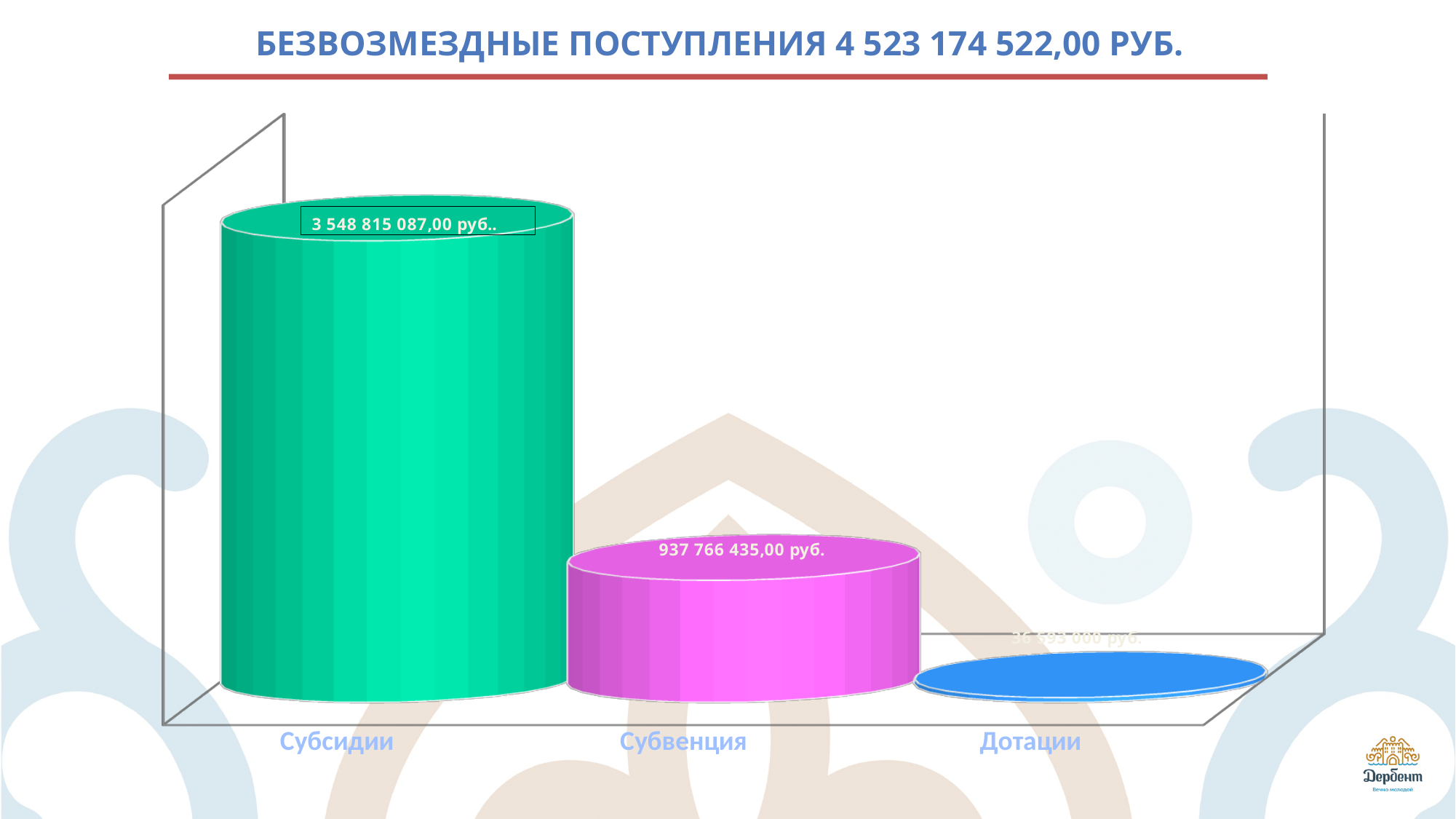
What is the difference between the values for Субсидии and Субвенция? 2 611 048 652,00 руб. What is the value shown for Субсидии? 3 548 815 087,00 руб. What is the title of the slide? БЕЗВОЗМЕЗДНЫЕ ПОСТУПЛЕНИЯ 4 523 174 522,00 РУБ. What kind of chart is shown on the slide? Bar chart Which category has the lowest value? Дотации Which is larger, the value for Субвенция or the value for Дотации? Субвенция Do the values rise or fall from left to right across the categories? Fall Which category has the highest value? Субсидии What is the value shown for Субвенция? 937 766 435,00 руб. How many categories are shown in the chart? 3 Which is larger, the value for Субсидии or the value for Субвенция? Субсидии What colour is the bar for Субвенция? Pink (magenta)